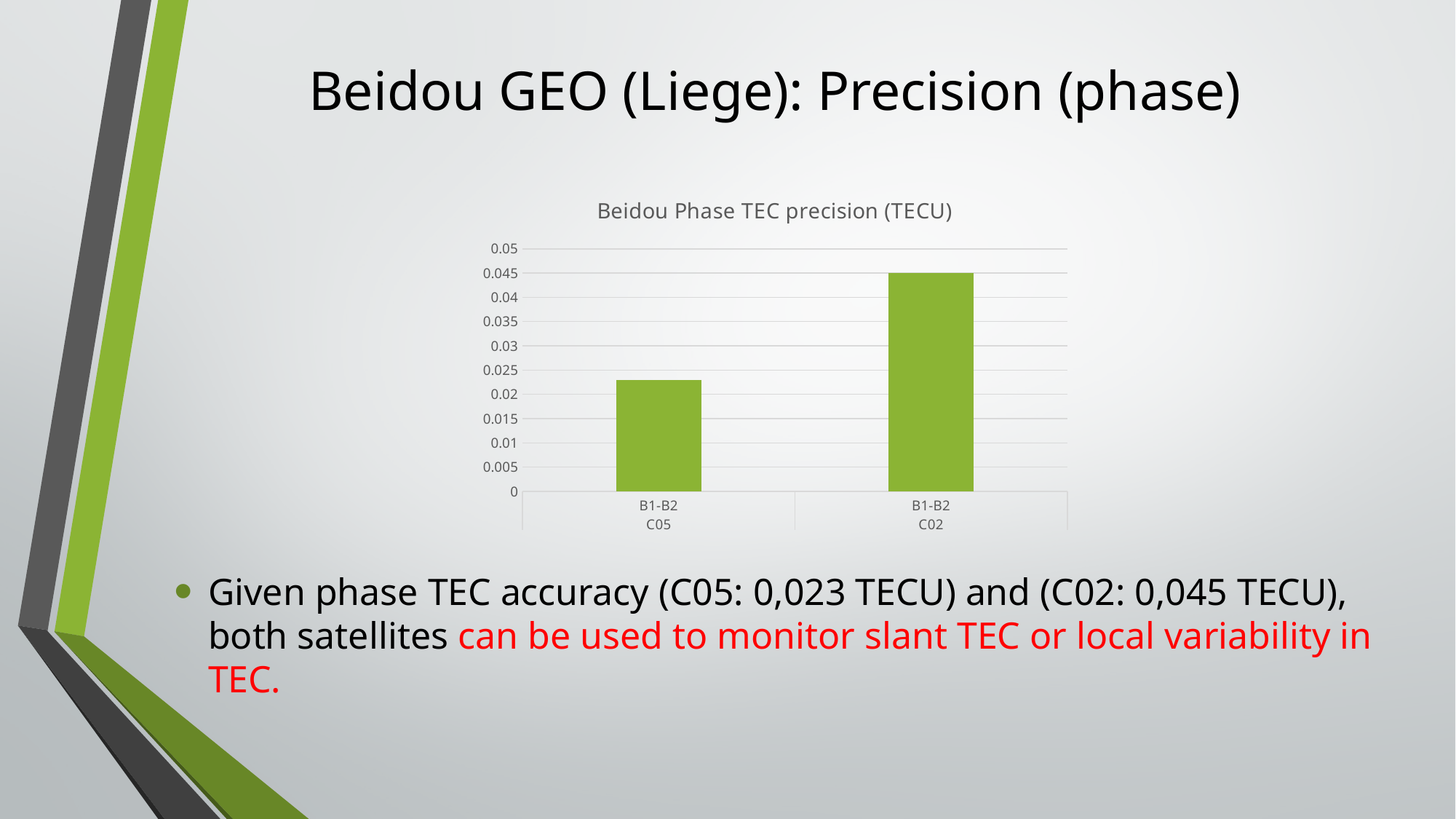
What is the phase TEC precision value for B1-B2 C02? 0.045 Which category has the lowest phase TEC precision value? B1-B2 C05 What is the maximum value shown on the vertical axis? 0.05 How many bars are plotted in the chart? 2 What type of chart is shown on the slide? bar chart Which category has the highest phase TEC precision value? B1-B2 C02 Is the value for B1-B2 C05 greater or less than 0.025? less What is the difference between the values for B1-B2 C02 and B1-B2 C05? 0.022 Which is larger, the value for B1-B2 C05 or B1-B2 C02? B1-B2 C02 Is the value for B1-B2 C02 greater or less than 0.04? greater What is the title of the chart? Beidou Phase TEC precision (TECU) What is the phase TEC precision value for B1-B2 C05? 0,023 TECU